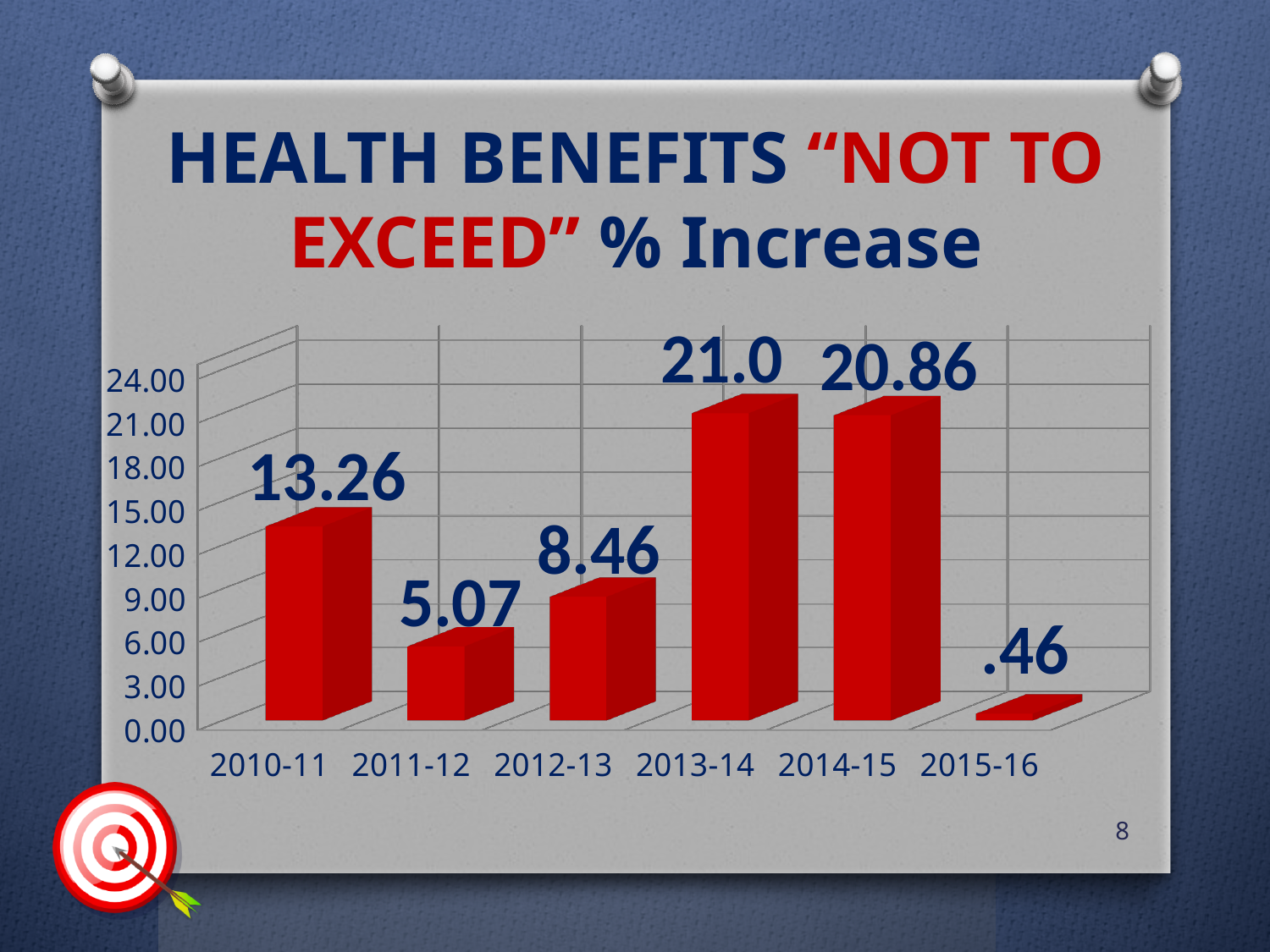
What kind of chart is shown on the slide? bar chart What is the value for 2012-13? 8.46 What is the value for 2010-11? 13.26 What is the value for 2015-16? .46 How many years are shown on the x axis? 6 What is the difference between the values for 2010-11 and 2011-12? 8.19 Is the value for 2014-15 greater or less than 18.00? greater Which year has the lowest value? 2015-16 Which is larger, the value for 2012-13 or the value for 2011-12? 2012-13 Which year has the highest value? 2013-14 What is the title of the chart on the slide? HEALTH BENEFITS "NOT TO EXCEED" % Increase What is the difference between the values for 2013-14 and 2014-15? 0.14